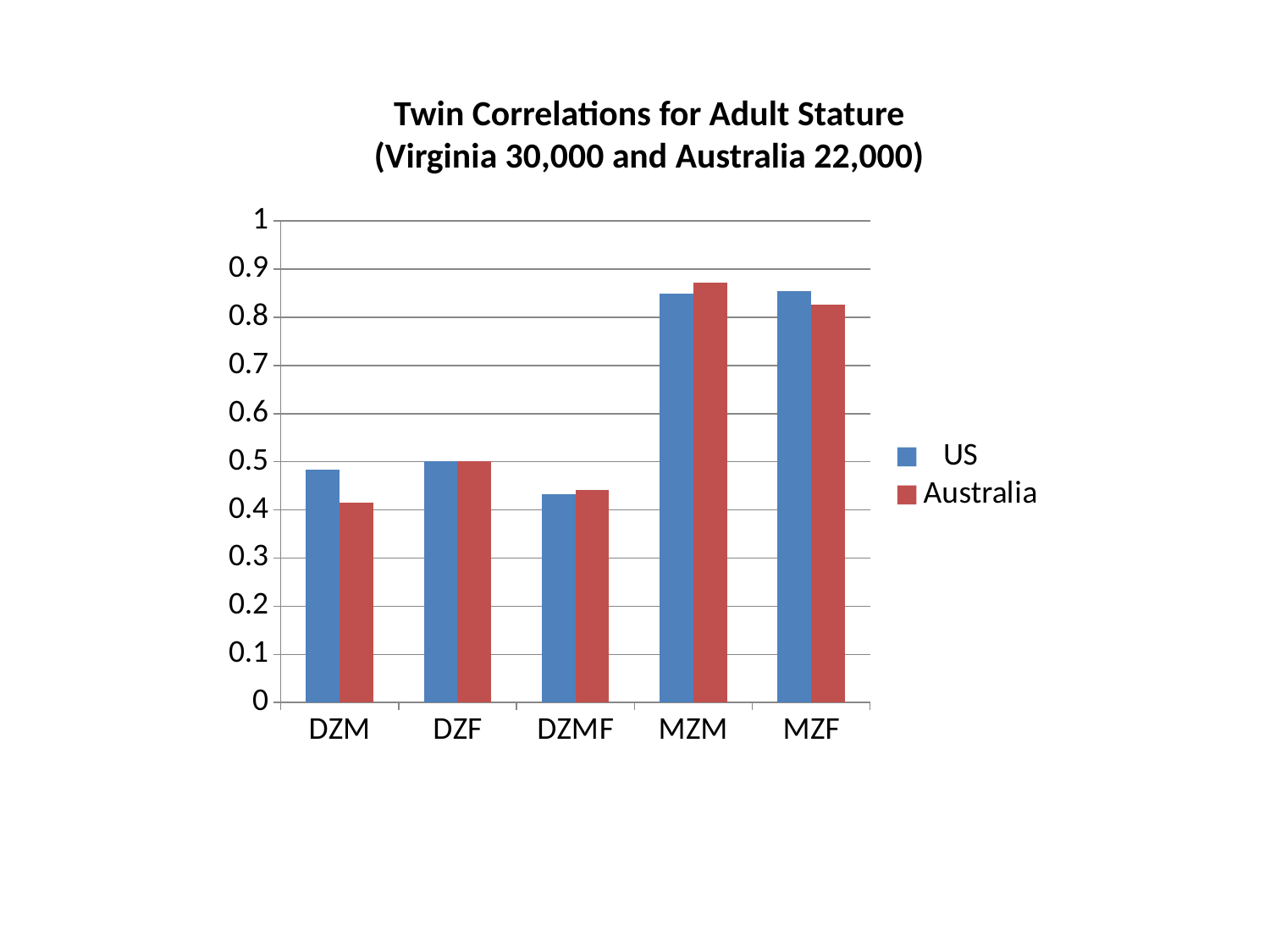
Which category has the lowest Australia value? DZM Is the Australia value for DZM greater or less than 0.5? less What is the title of the chart? Twin Correlations for Adult Stature (Virginia 30,000 and Australia 22,000) Which category has the highest Australia value? MZM What kind of chart is shown on the slide? bar chart How many series does the legend list? 2 Which category has the lowest US value? DZMF Which colour represents the Australia series? red Is the Australia value for MZM greater or less than 0.8? greater For DZM, which is larger, the US value or the Australia value? US How many twin categories are shown on the x axis? 5 For MZF, which is larger, the US value or the Australia value? US